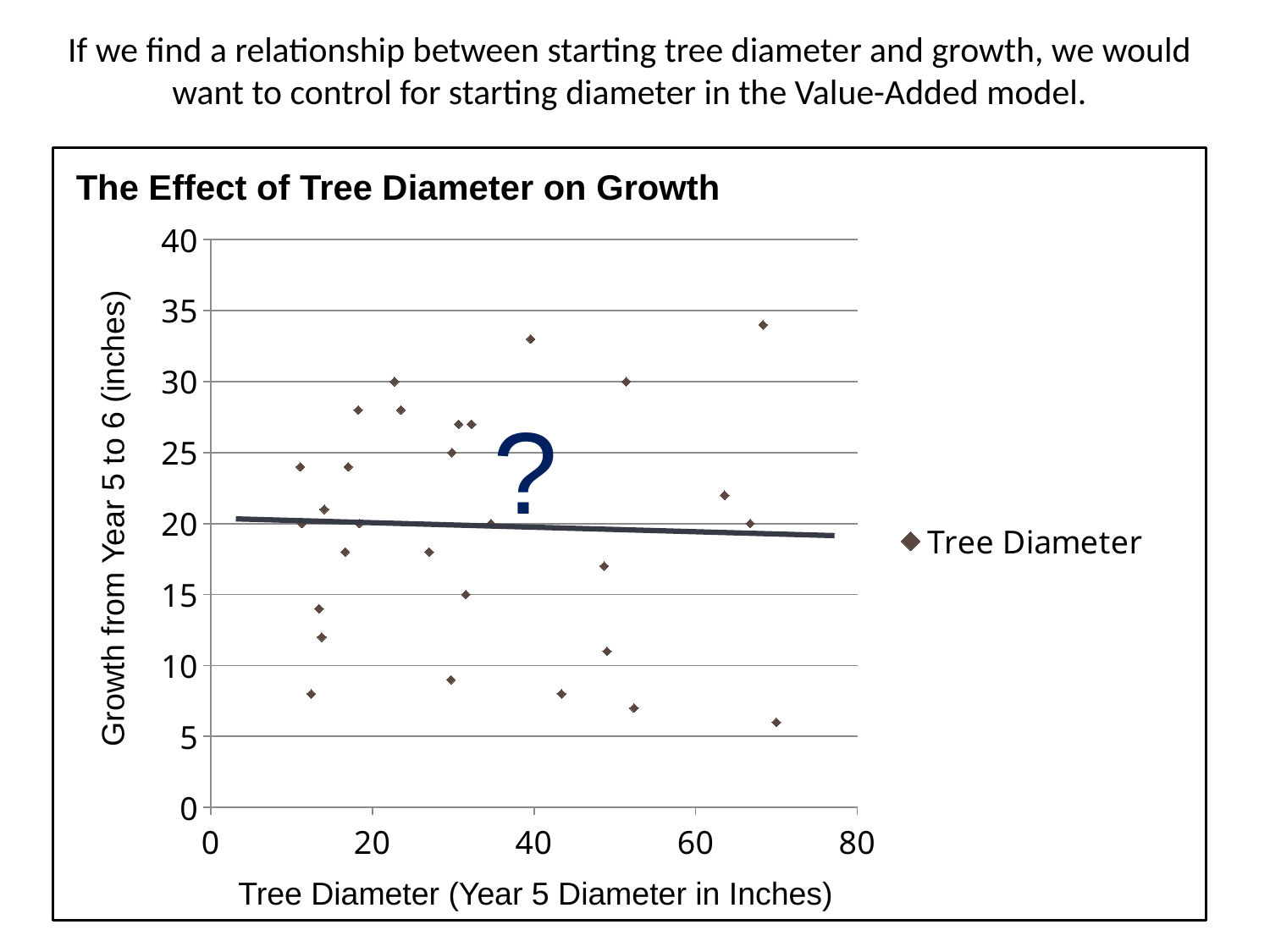
What is the title of the chart? The Effect of Tree Diameter on Growth How many series does the legend list? 1 What kind of chart is shown on the slide? scatter chart Is the trend line's value at a tree diameter of 20 greater or less than 25? less Is the highest growth value plotted in the chart greater or less than 30? greater Is the lowest growth value plotted in the chart greater or less than 10? less What is the name of the series shown in the legend? Tree Diameter What is the maximum value shown on the horizontal axis? 80 What is the maximum value shown on the vertical axis? 40 Does the trend line in the chart rise or fall as tree diameter increases? fall